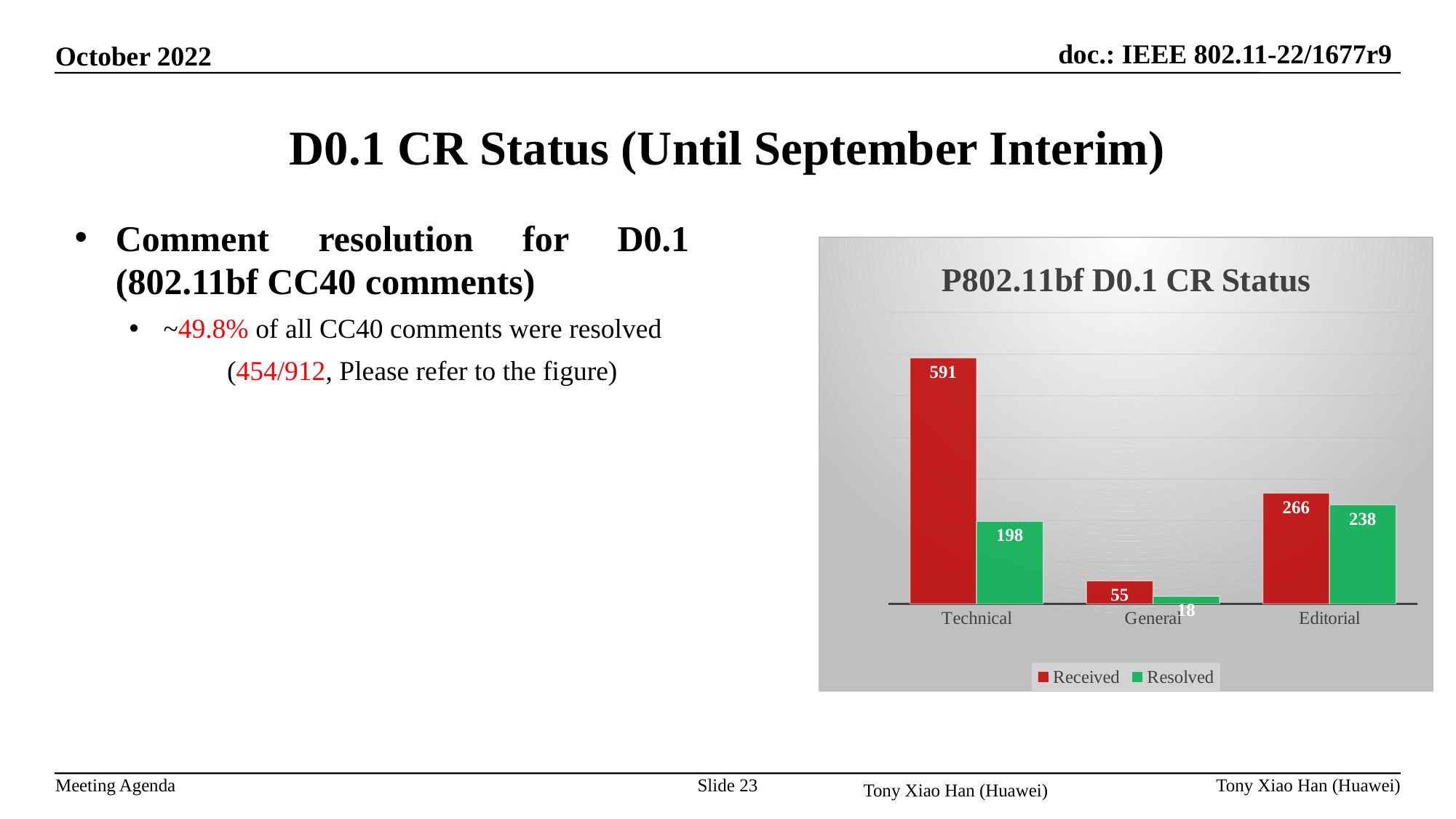
What is the title of the chart? P802.11bf D0.1 CR Status How many categories are shown on the x axis? 3 Which category has the lowest Resolved value? General What is the Resolved value for Editorial comments? 238 What is the Received value for Technical comments? 591 What is the difference between Received and Resolved for Technical comments? 393 What is the difference between Received and Resolved for Editorial comments? 28 What kind of chart is shown on the slide? Bar chart Which category has the highest Received value? Technical How many series does the legend list? 2 What is the Resolved value for General comments? 18 Which is larger: the Resolved value for Technical or the Resolved value for Editorial? Editorial